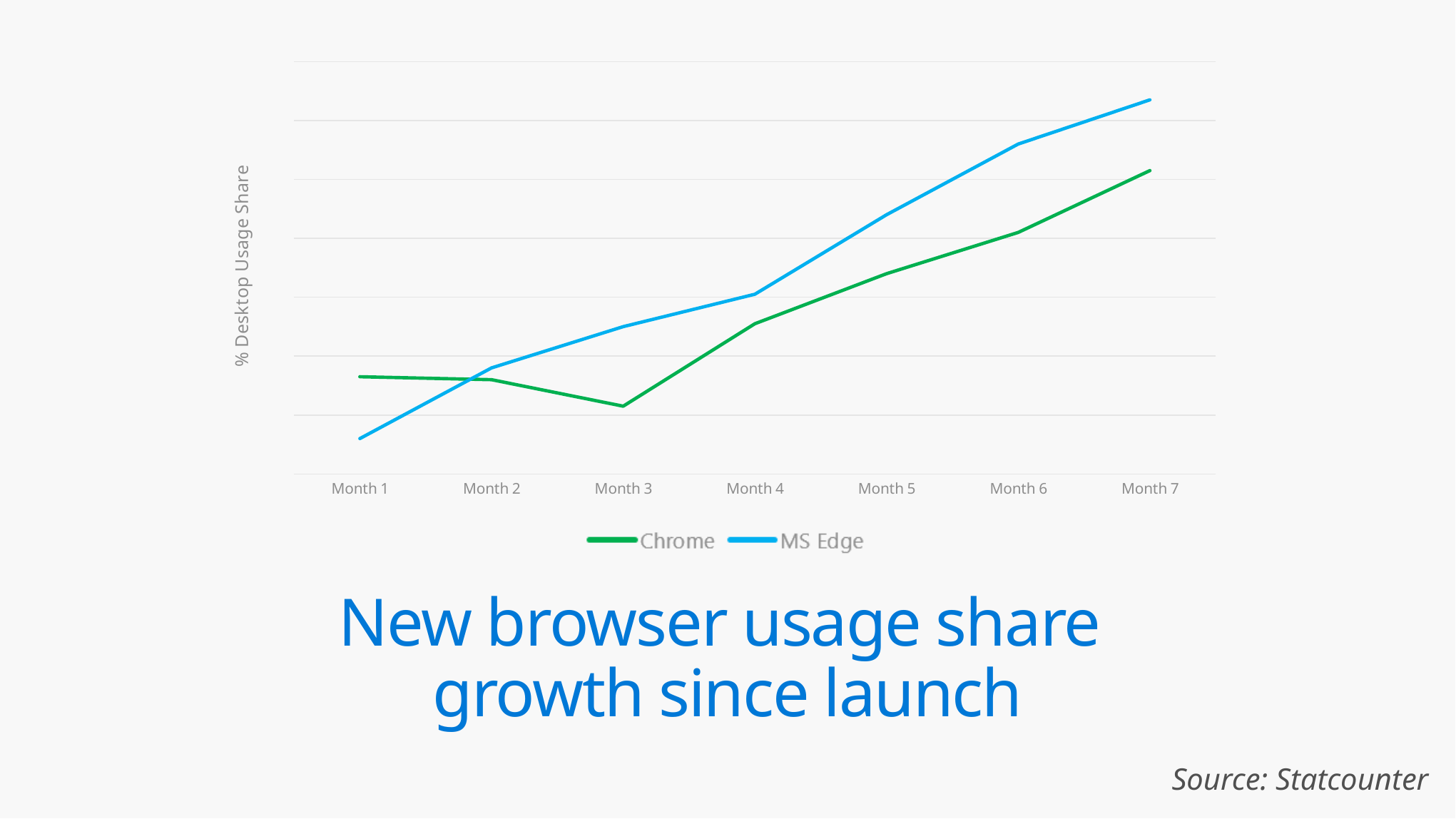
Does the MS Edge line rise or fall from Month 1 to Month 7? Rise At Month 5, which series has the higher value, Chrome or MS Edge? MS Edge What kind of chart is shown on the slide? Line chart How many series does the legend list? 2 In which month is the Chrome value lowest? Month 3 How many months are plotted along the x axis? 7 What is the label on the y axis? % Desktop Usage Share At Month 1, which series has the higher value, Chrome or MS Edge? Chrome In which month is the MS Edge value lowest? Month 1 In which month does MS Edge reach its highest value? Month 7 In which month does Chrome reach its highest value? Month 7 What is the title shown below the chart? New browser usage share growth since launch